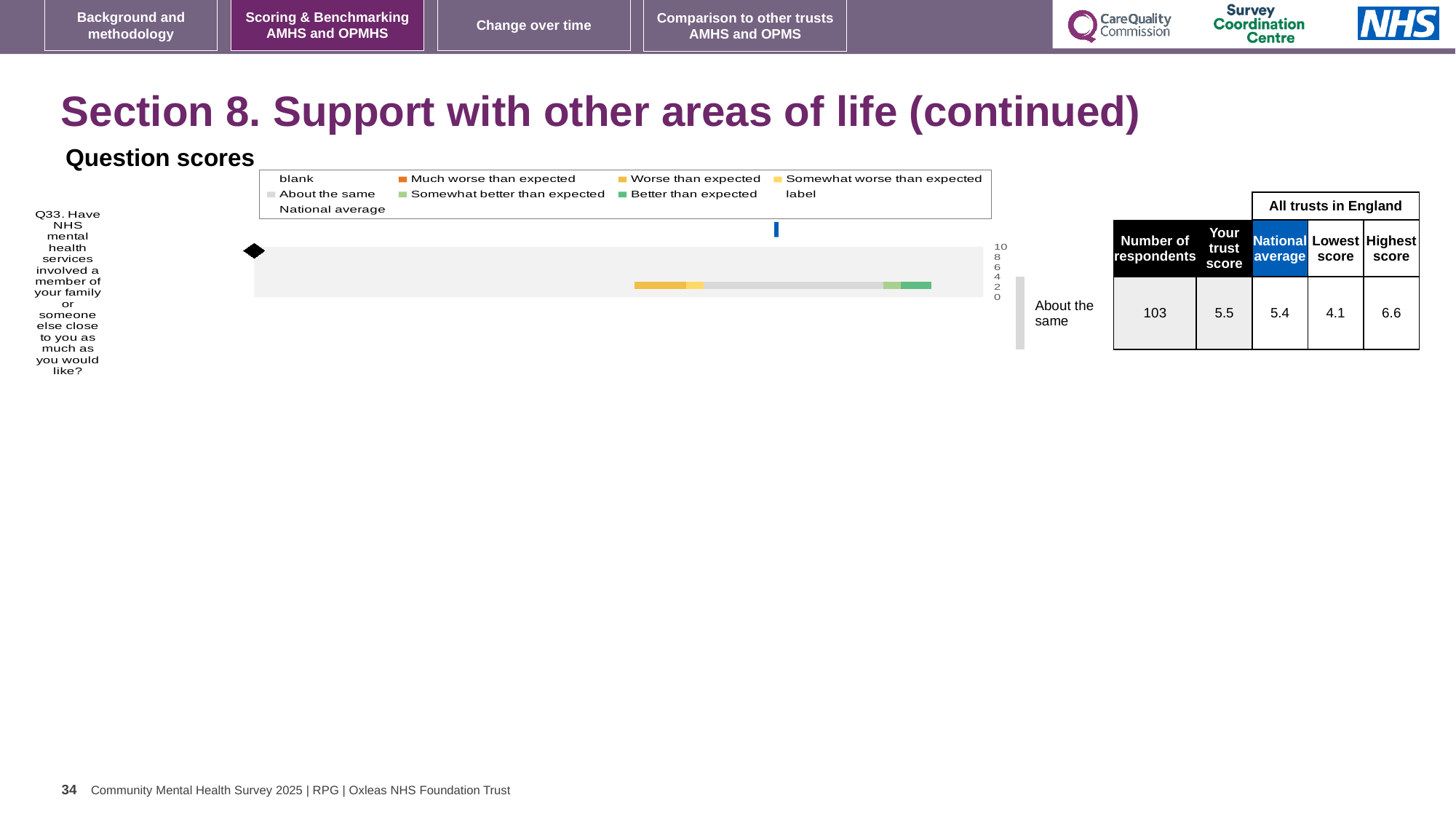
In the table beside the chart, how many respondents answered Q33? 103 Which legend entry is shown in light grey? About the same What kind of chart is used to show the Q33 question score? bar chart Which legend entry is shown in dark green? Better than expected In the table beside the chart, what is the national average for Q33? 5.4 In the table beside the chart, what is the highest score among all trusts in England for Q33? 6.6 In the table beside the chart, what is the trust's score for Q33? 5.5 How many entries does the chart's legend list? 9 What is the difference between the highest score and the lowest score for Q33 in the table? 2.5 Which is larger for Q33, the trust's score or the national average? the trust's score Which benchmark category does the trust's score for Q33 fall into, according to the label beside the chart? About the same How many questions (categories) are plotted on the chart? 1